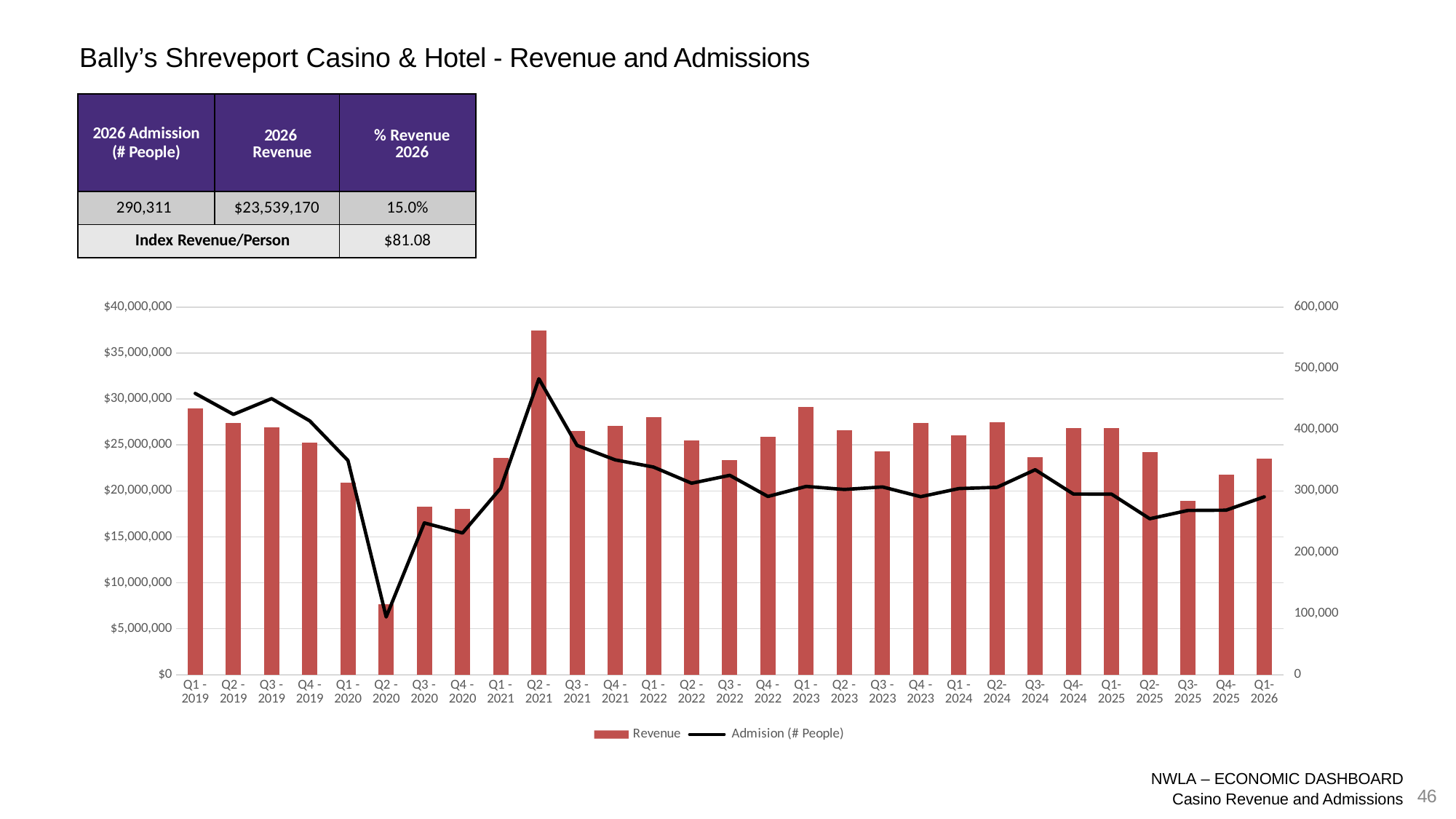
Is the Revenue for Q2 - 2020 greater or less than $10,000,000? less Which quarter has the lowest Revenue bar? Q2 - 2020 Which quarter has the highest Revenue bar? Q2 - 2021 Is the Admission (# People) value for Q1 - 2019 greater or less than 400,000? greater Is the Admission (# People) value for Q2 - 2025 greater or less than 300,000? less Which quarter has the lowest Admission (# People) value on the line? Q2 - 2020 How many quarters are plotted along the x axis of the chart? 29 Does the Admission (# People) line rise or fall from Q1 - 2019 to Q2 - 2020? fall Which has the larger Revenue bar, Q1 - 2023 or Q3 - 2023? Q1 - 2023 How many series does the chart legend list? 2 What kind of chart is shown on the slide? A combination bar and line chart